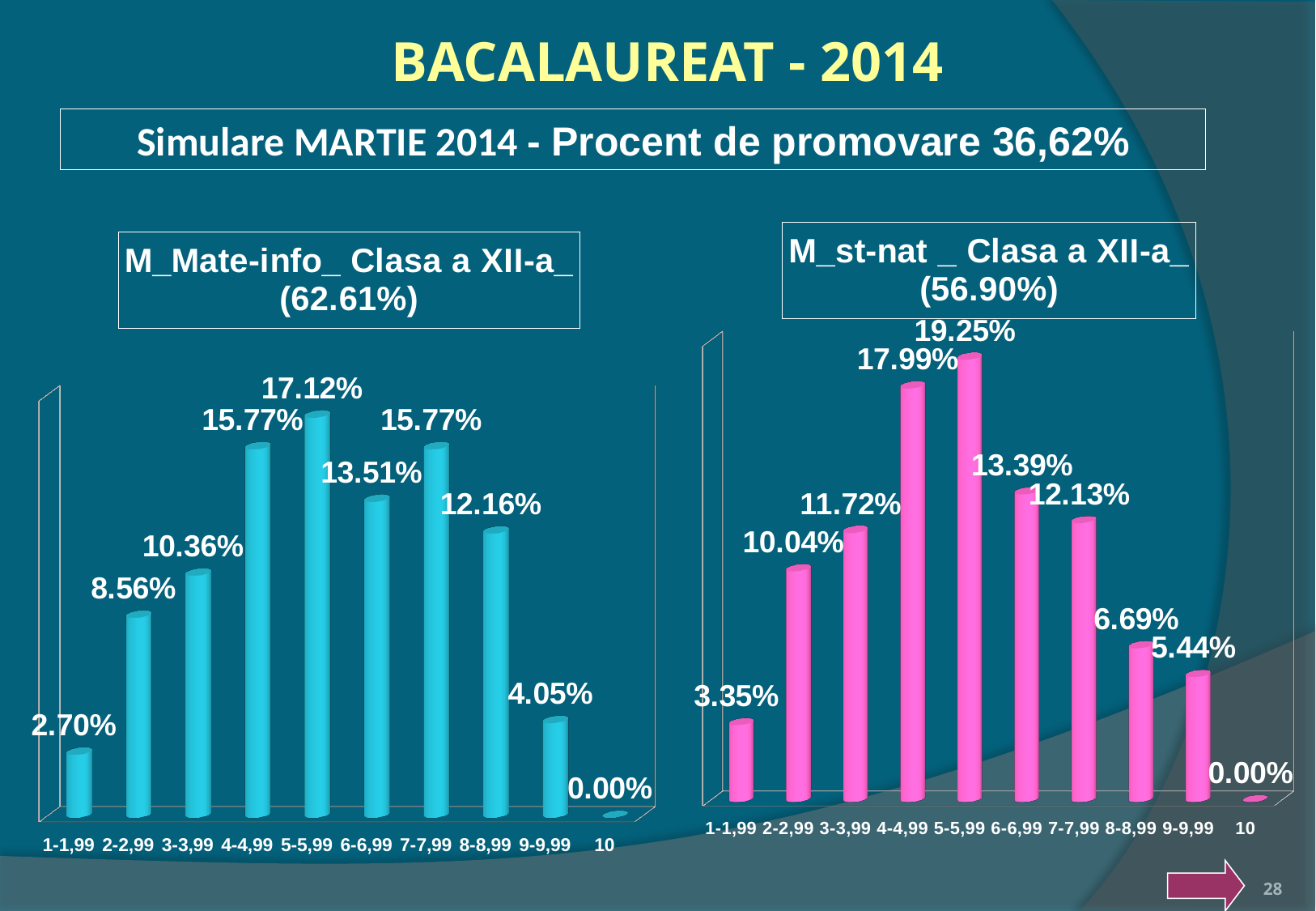
In the M_st-nat _ Clasa a XII-a_ (56.90%) chart, which category has the lowest value? 10 How many categories are shown on the x axis of the M_Mate-info_ Clasa a XII-a_ (62.61%) chart? 10 In the M_Mate-info_ Clasa a XII-a_ (62.61%) chart, which is larger: the value for 6-6,99 or the value for 8-8,99? 6-6,99 In the M_Mate-info_ Clasa a XII-a_ (62.61%) chart, which category has the highest value? 5-5,99 In the M_st-nat _ Clasa a XII-a_ (56.90%) chart, what is the difference between the values for 5-5,99 and 4-4,99? 1.26% In the M_st-nat _ Clasa a XII-a_ (56.90%) chart, do the values rise or fall from 5-5,99 to 10? fall In the M_st-nat _ Clasa a XII-a_ (56.90%) chart, which is larger: the value for 8-8,99 or the value for 9-9,99? 8-8,99 What kind of chart is the M_st-nat _ Clasa a XII-a_ (56.90%) chart? bar chart In the M_Mate-info_ Clasa a XII-a_ (62.61%) chart, what is the value for the 5-5,99 category? 17.12% What colour are the bars in the M_Mate-info_ Clasa a XII-a_ (62.61%) chart? light blue In the M_Mate-info_ Clasa a XII-a_ (62.61%) chart, what is the difference between the values for 8-8,99 and 9-9,99? 8.11% In the M_st-nat _ Clasa a XII-a_ (56.90%) chart, what is the value for the 2-2,99 category? 10.04%